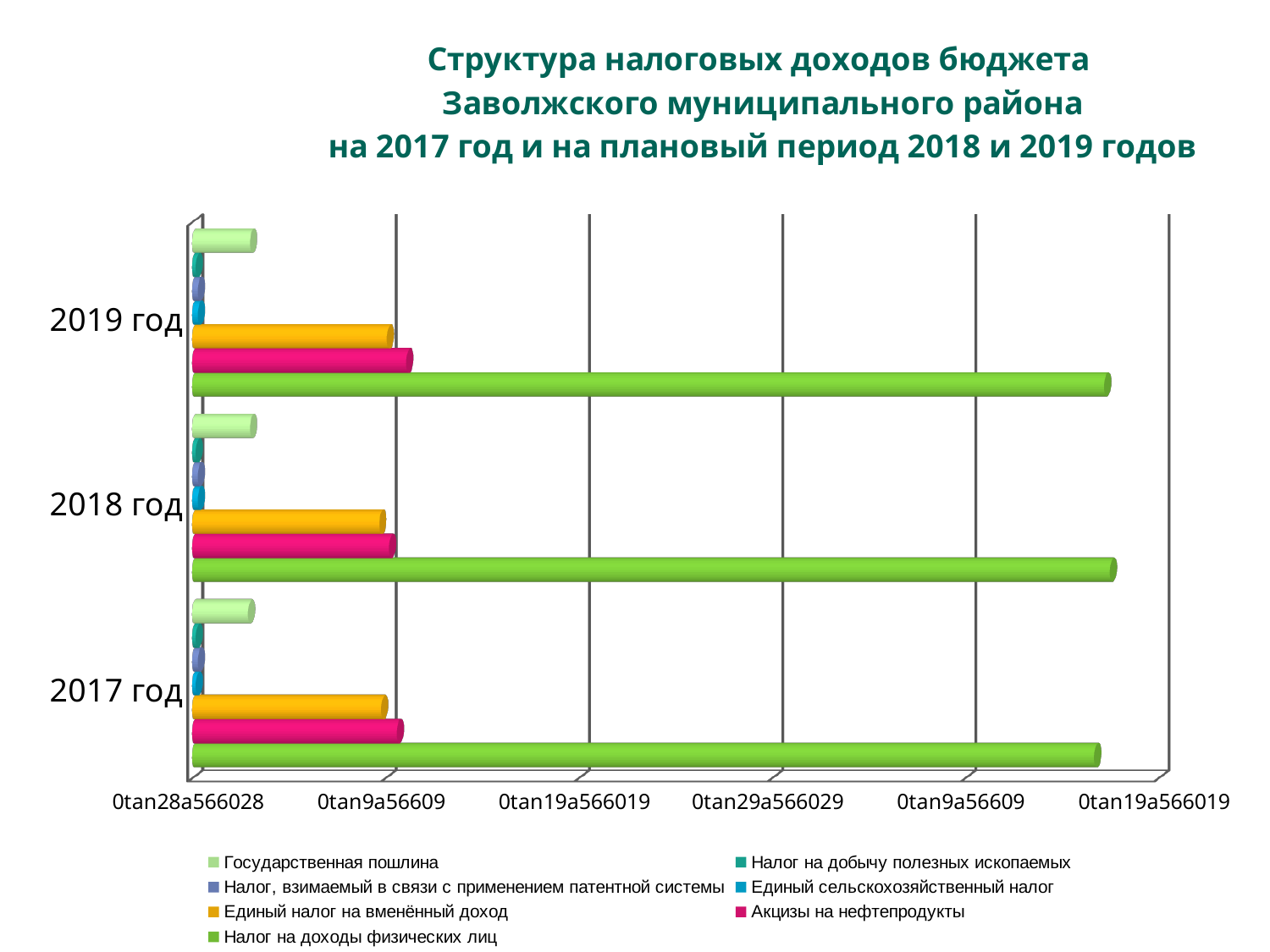
Which year categories are listed on the vertical axis of the chart? 2017 год, 2018 год, 2019 год What kind of chart is shown on the slide? Bar chart For 2018 год, which is larger: Налог на доходы физических лиц or Акцизы на нефтепродукты? Налог на доходы физических лиц Which series is shown in pink/magenta in the chart legend? Акцизы на нефтепродукты How many year categories are shown on the vertical axis of the chart? 3 How many series does the chart legend list? 7 Which series has the longest bar for 2017 год? Налог на доходы физических лиц For 2019 год, which is larger: Акцизы на нефтепродукты or Государственная пошлина? Акцизы на нефтепродукты For 2017 год, which is larger: Государственная пошлина or Единый налог на вменённый доход? Единый налог на вменённый доход Which series has the longest bar for 2019 год? Налог на доходы физических лиц